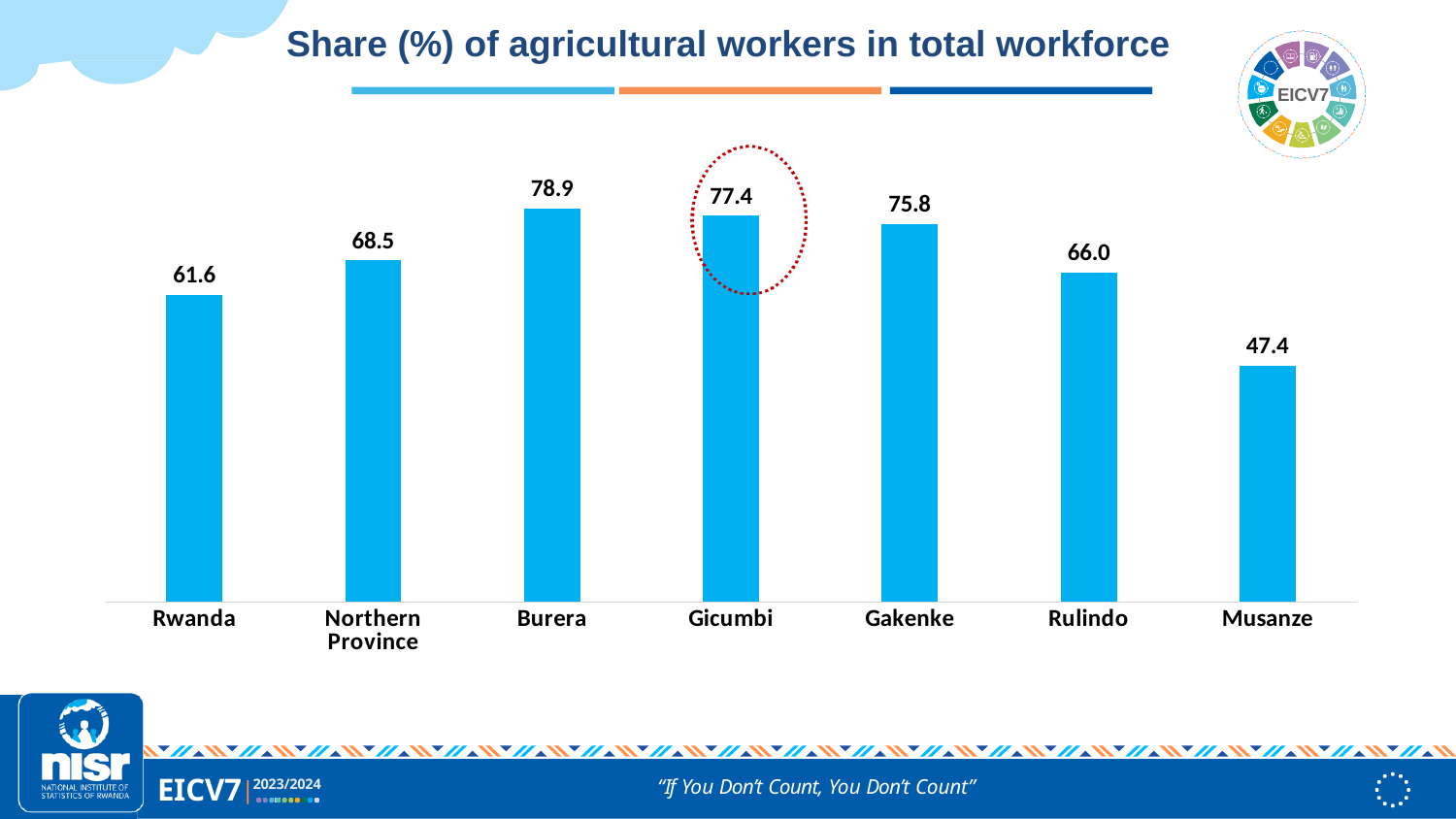
What kind of chart is shown on the slide? Bar chart What is the difference between the values for Gicumbi and Rwanda? 15.8 Which is larger, the value for Gakenke or the value for Rulindo? Gakenke What is the title of the chart? Share (%) of agricultural workers in total workforce Which category has the highest share of agricultural workers? Burera What is the share of agricultural workers in the total workforce for Gicumbi? 77.4 What is the value shown for Northern Province? 68.5 How many categories are shown on the x axis? 7 Which bar is highlighted with a dotted red circle? Gicumbi What is the value shown for Rwanda? 61.6 Which category has the lowest share of agricultural workers? Musanze What is the difference between the values for Burera and Musanze? 31.5